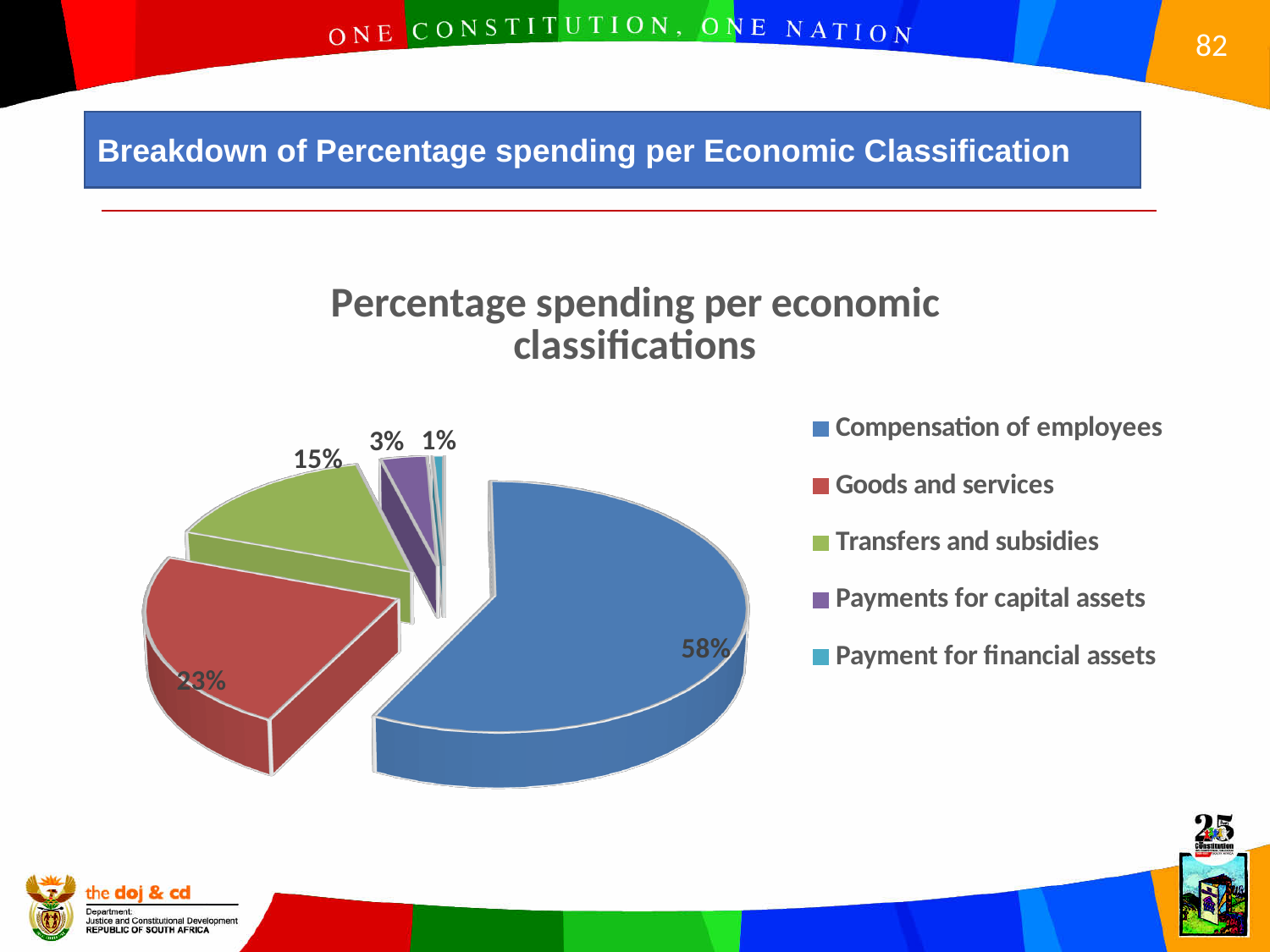
What percentage of spending is for Compensation of employees? 58% What percentage of spending is for Payments for capital assets? 3% What is the difference in percentage points between Compensation of employees and Goods and services? 35 What percentage of spending is for Transfers and subsidies? 15% What is the chart's title? Percentage spending per economic classifications Which is larger, the share for Transfers and subsidies or the share for Payments for capital assets? Transfers and subsidies What percentage of spending is for Goods and services? 23% What kind of chart is shown on the slide? Pie chart Which economic classification has the largest share of spending? Compensation of employees What percentage of spending is for Payment for financial assets? 1% How many economic classifications are shown in the pie chart? 5 Which economic classification has the smallest share of spending? Payment for financial assets